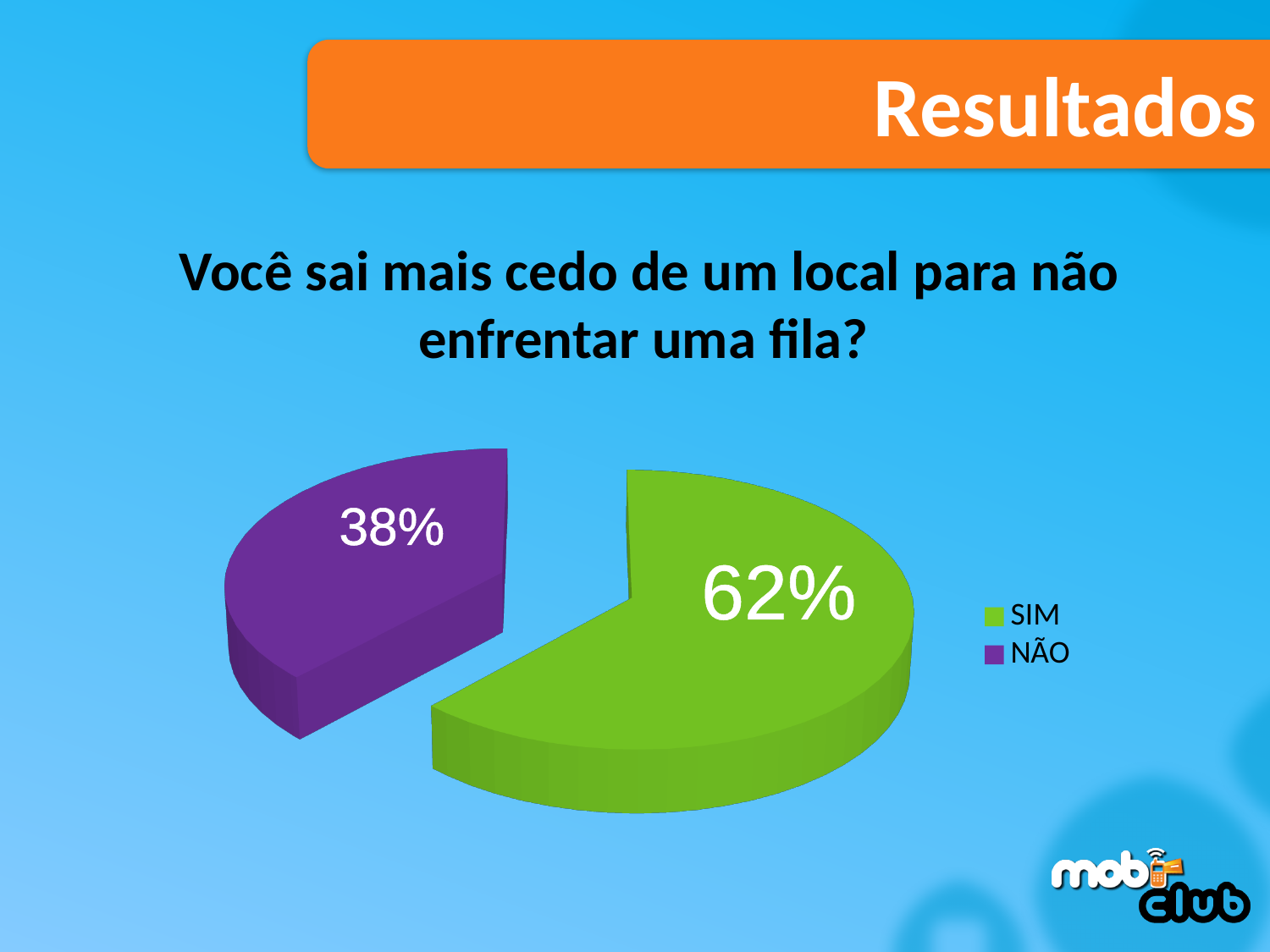
What type of chart is shown on the slide? pie chart How many slices does the pie chart have? 2 Which response has the smallest share of the pie? NÃO What colour is the SIM slice? green What question does the chart present results for? Você sai mais cedo de um local para não enfrentar uma fila? Which slice is larger, SIM or NÃO? SIM How many entries does the legend list? 2 Is the share for NÃO greater or less than 50%? less What percentage of respondents answered SIM? 62% Which response has the largest share of the pie? SIM What percentage of respondents answered NÃO? 38% What is the difference in percentage points between the SIM and NÃO slices? 24